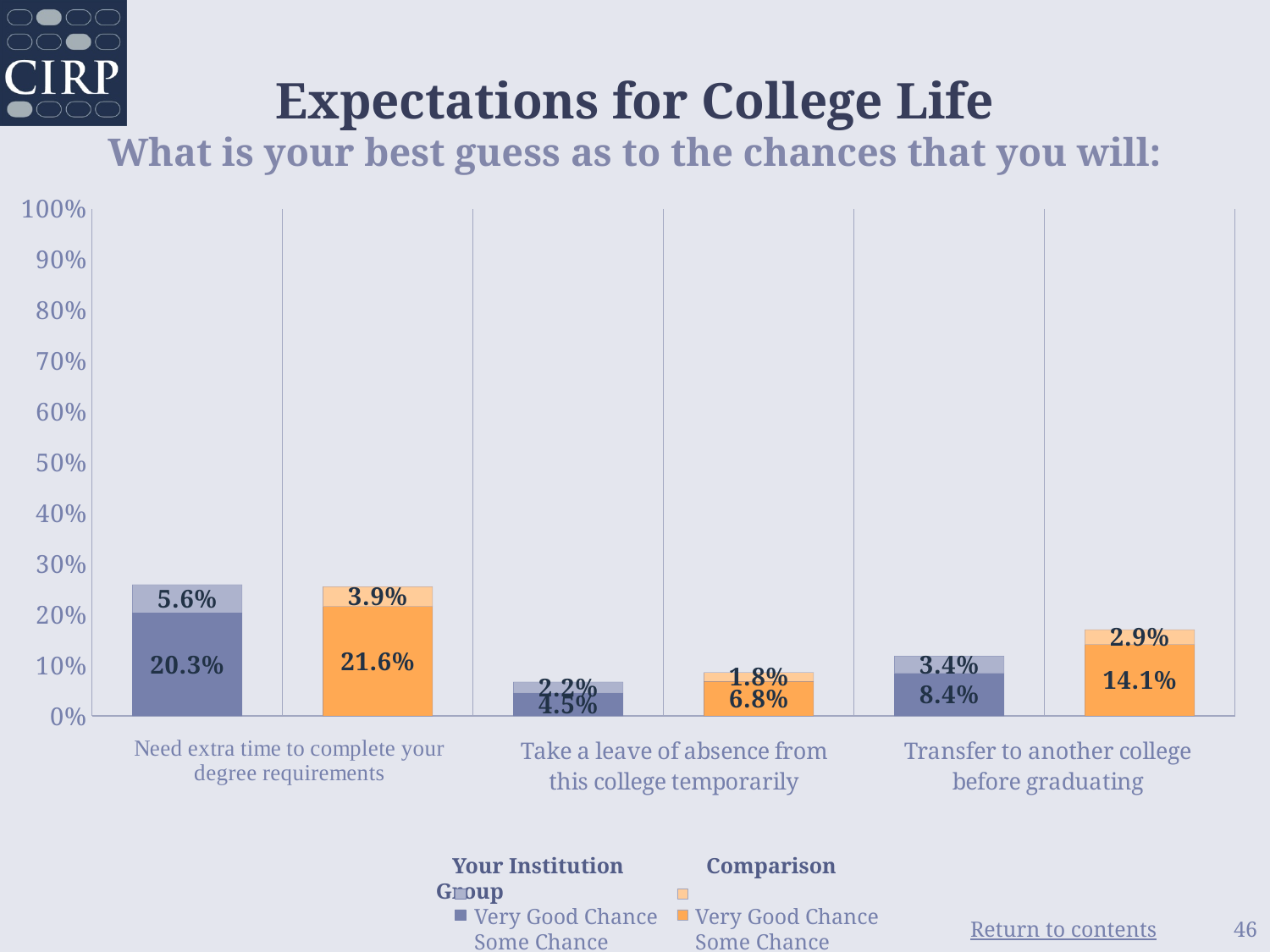
How many categories are shown on the x axis? 3 What is the Very Good Chance value for the Comparison Group for 'Take a leave of absence from this college temporarily'? 1.8% What is the total of the stacked bar for Your Institution for 'Transfer to another college before graduating'? 11.8% What kind of chart is shown on the slide? Stacked bar chart What is the Very Good Chance value for Your Institution for 'Need extra time to complete your degree requirements'? 5.6% What is the title of the chart? Expectations for College Life For 'Need extra time to complete your degree requirements', which is larger: the Very Good Chance value for Your Institution or for the Comparison Group? Your Institution What is the Some Chance value for Your Institution for 'Take a leave of absence from this college temporarily'? 4.5% Which category has the lowest Very Good Chance value for Your Institution? Take a leave of absence from this college temporarily What is the difference between the Comparison Group and Your Institution Very Good Chance values for 'Transfer to another college before graduating'? 0.5% Which category has the highest Very Good Chance value for the Comparison Group? Need extra time to complete your degree requirements What is the Some Chance value for the Comparison Group for 'Transfer to another college before graduating'? 14.1%